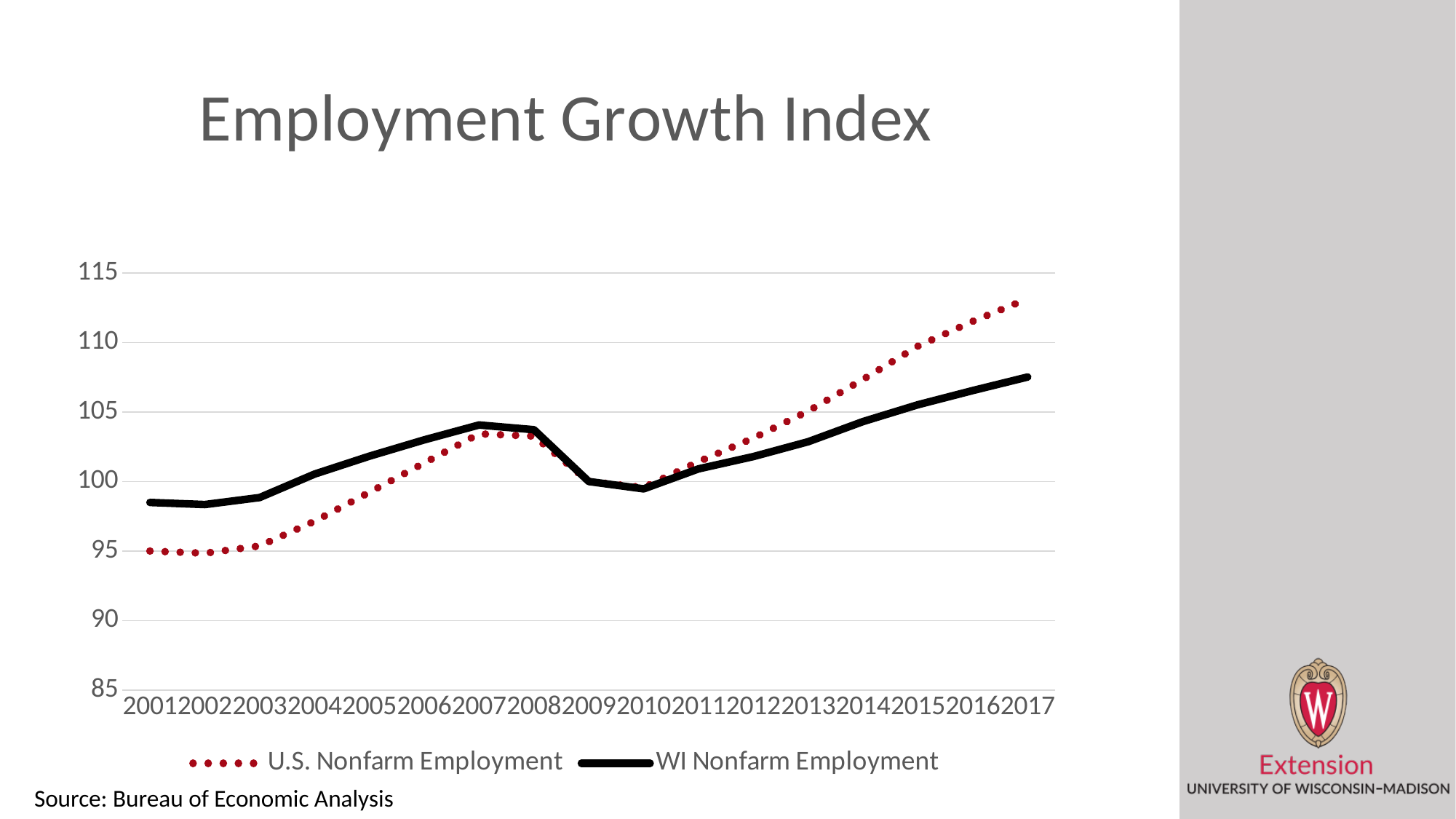
What type of chart is shown on the slide? line chart In 2017, which series has the higher value, U.S. Nonfarm Employment or WI Nonfarm Employment? U.S. Nonfarm Employment Is the value for WI Nonfarm Employment in 2007 greater or less than 100? greater How many series does the legend list? 2 Is the value for U.S. Nonfarm Employment in 2004 greater or less than 100? less Is the value for U.S. Nonfarm Employment in 2017 greater or less than 110? greater How many years are plotted along the x axis? 17 What is the title of the chart? Employment Growth Index In 2003, which series has the higher value, U.S. Nonfarm Employment or WI Nonfarm Employment? WI Nonfarm Employment Which series is drawn as a dotted red line? U.S. Nonfarm Employment In which year does U.S. Nonfarm Employment reach its highest value? 2017